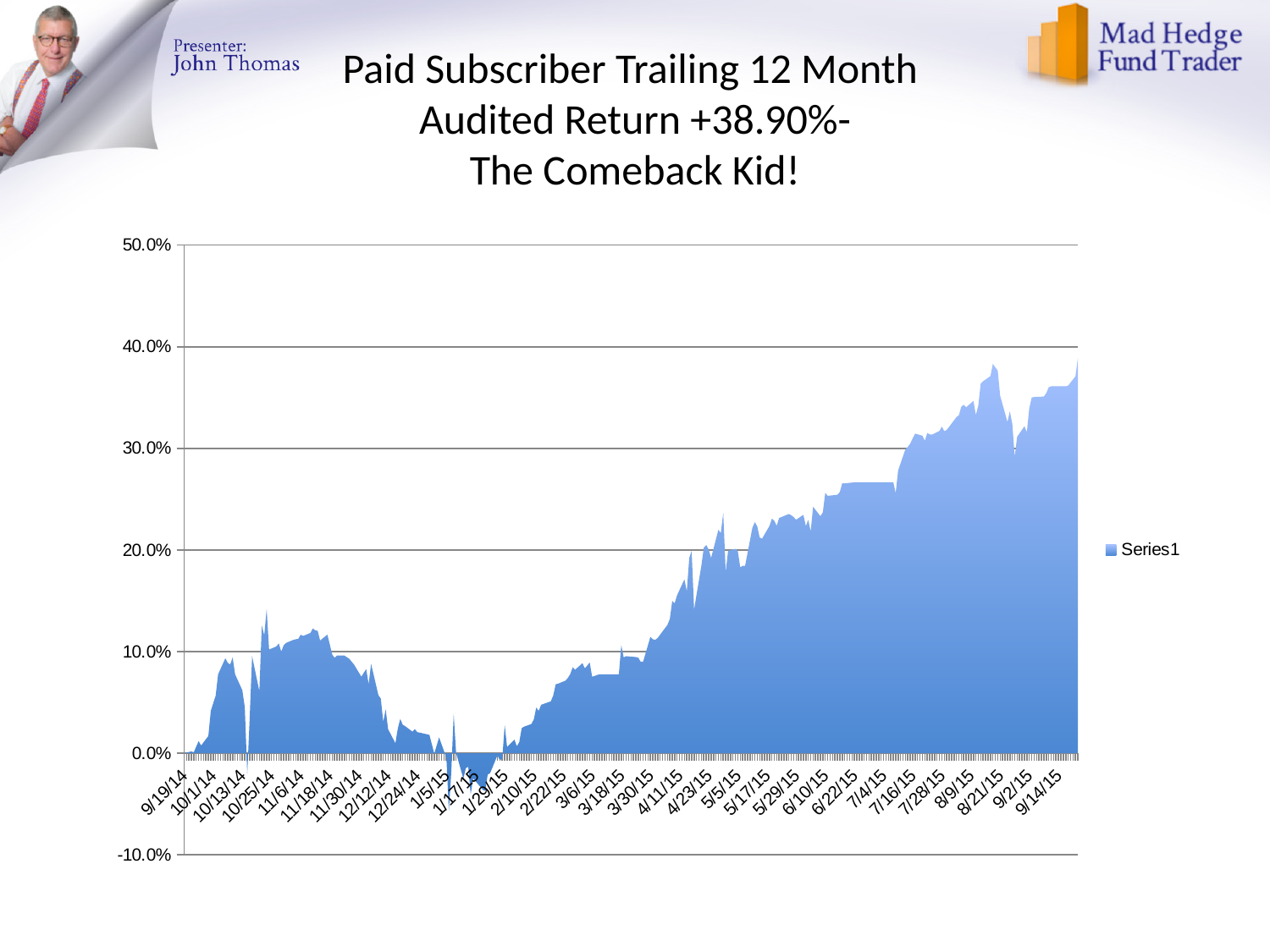
Is the value at 12/24/14 greater or less than 10.0%? less Is the value at 1/17/15 greater or less than 0.0%? less Which is larger, the value at 3/6/15 or the value at 6/22/15? 6/22/15 Overall, do the values rise or fall from 9/19/14 to 9/14/15? rise Around which x-axis date does the series reach its lowest value? 1/5/15 What is the name of the series shown in the legend? Series1 Is the value at 11/6/14 greater or less than 20.0%? less What kind of chart is shown on the slide? area chart How many series does the legend list? 1 What audited return is stated in the chart's title? +38.90%